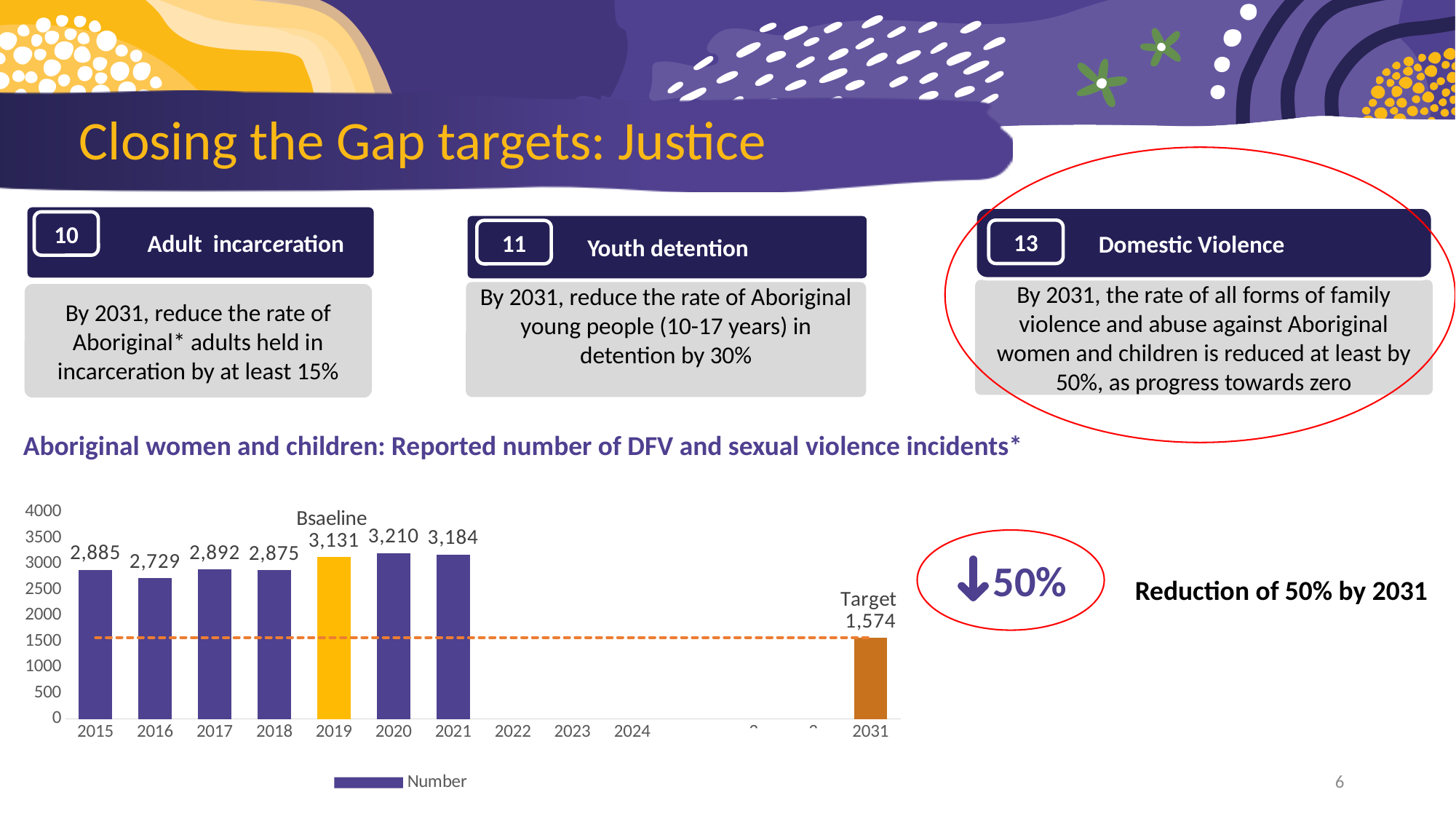
What is the reported number of DFV and sexual violence incidents for 2015? 2,885 Which year has the highest reported number of incidents? 2020 Is the value for 2016 greater or less than 3000? less What is the value of the baseline bar for 2019? 3,131 How many bars are plotted on the chart? 8 Which is larger, the value for 2017 or the value for 2018? 2017 What is the target number of incidents shown for 2031? 1,574 What is the difference between the 2020 value and the 2019 baseline value? 79 What kind of chart is shown on the slide? combination bar and line chart (bars with a dashed target line) Among the reported years 2015 to 2021, which year has the lowest number of incidents? 2016 What series name does the chart legend show? Number How much higher is the 2021 value than the 2031 target? 1,610